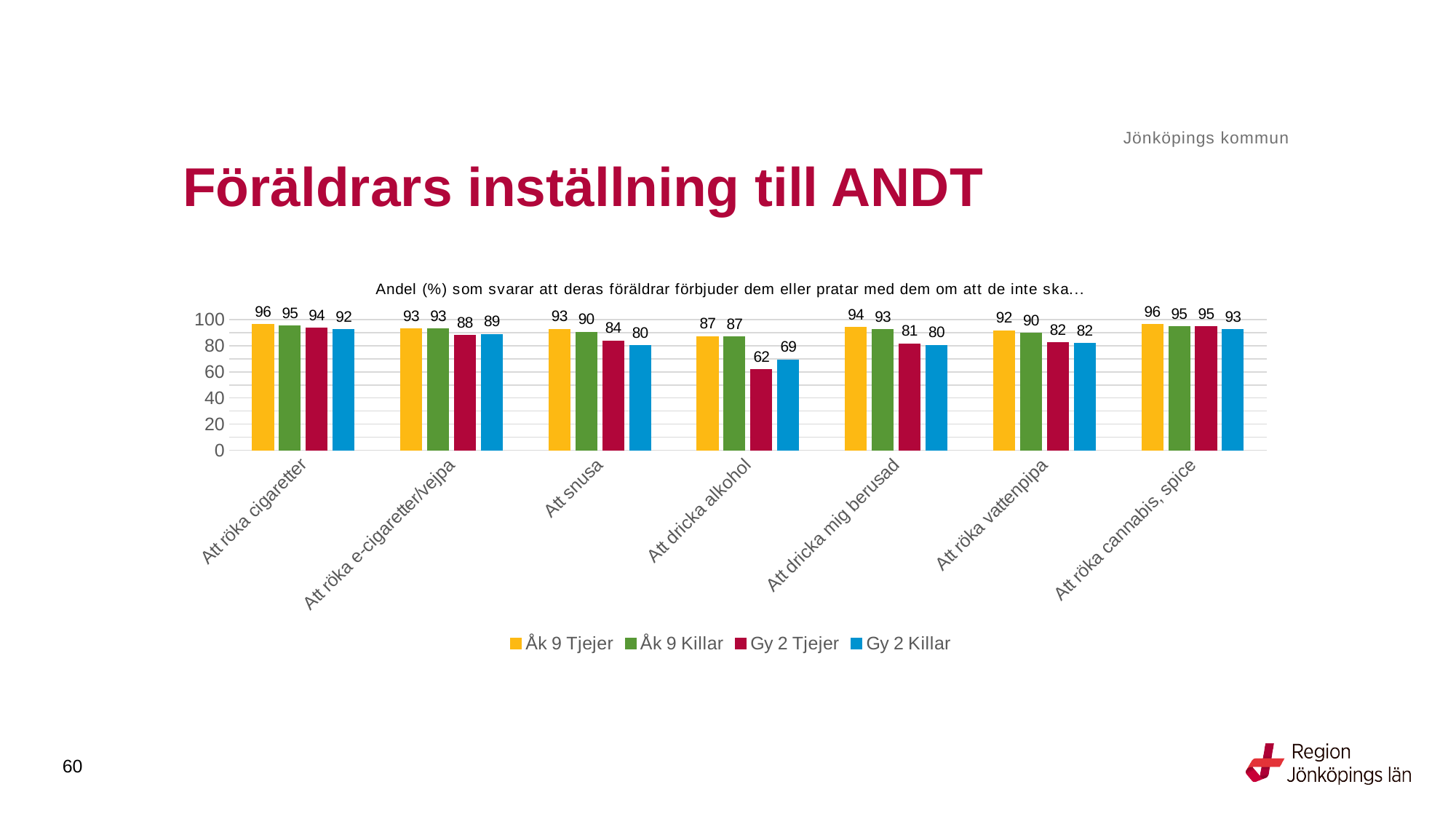
What is the value for Gy 2 Killar in the 'Att snusa' category? 80 Which series is shown in blue in the legend? Gy 2 Killar What is the value for Gy 2 Tjejer in the 'Att dricka alkohol' category? 62 How many series does the legend list? 4 What is the value for Åk 9 Tjejer in the 'Att röka cigaretter' category? 96 How many categories are shown on the x axis? 7 Which category has the lowest value for Gy 2 Tjejer? Att dricka alkohol What is the difference between Åk 9 Tjejer and Gy 2 Tjejer in the 'Att dricka alkohol' category? 25 Which is larger in the 'Att dricka mig berusad' category: Åk 9 Tjejer or Gy 2 Killar? Åk 9 Tjejer What is the difference between Gy 2 Tjejer and Gy 2 Killar in the 'Att dricka alkohol' category? 7 What is the value for Åk 9 Killar in the 'Att röka vattenpipa' category? 90 What kind of chart is shown on the slide? Bar chart